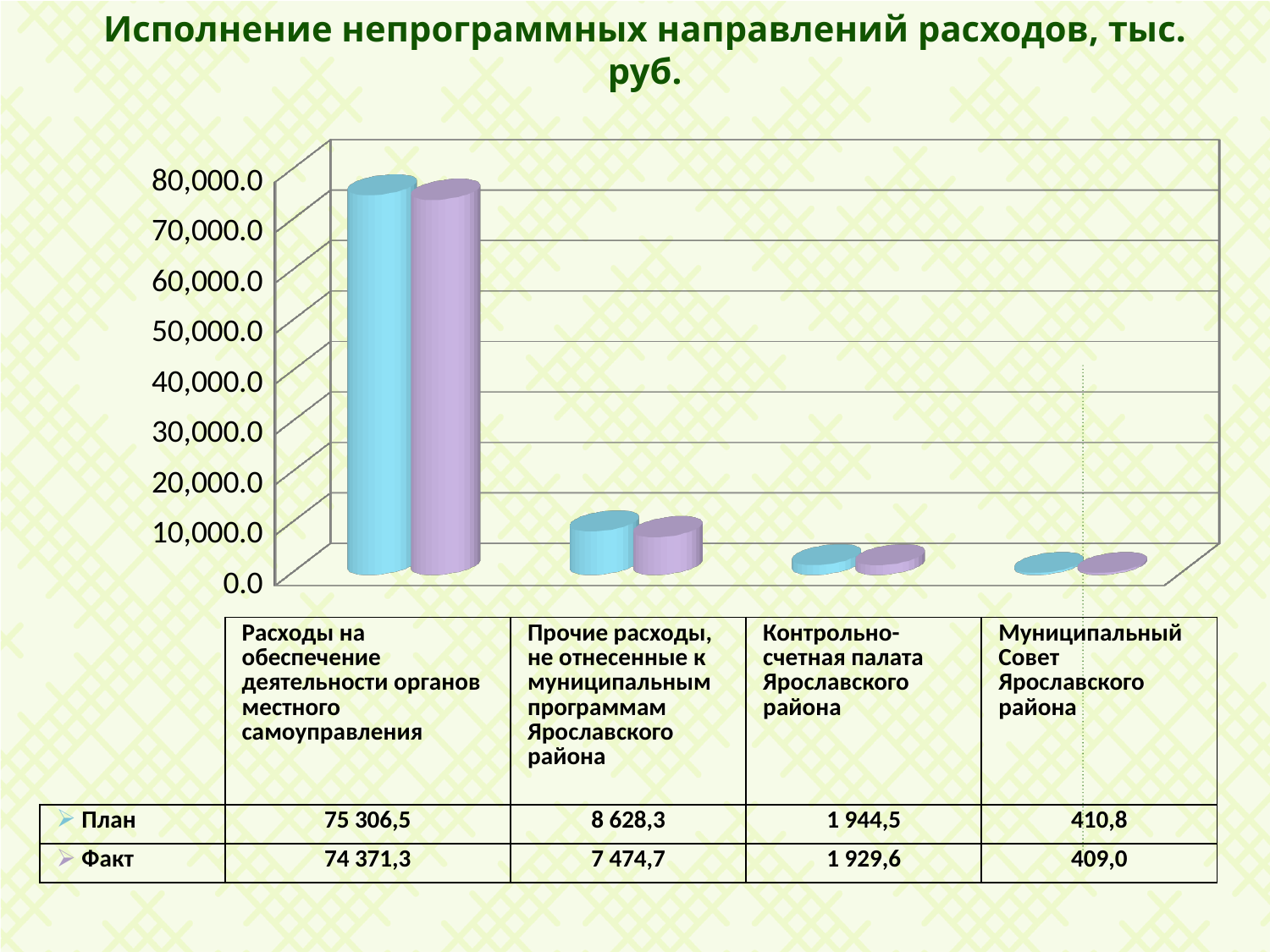
Which category has the lowest План value? Муниципальный Совет Ярославского района What is the План value for Контрольно-счетная палата Ярославского района? 1 944,5 What is the Факт value for Прочие расходы, не отнесенные к муниципальным программам Ярославского района? 7 474,7 What is the План value for Расходы на обеспечение деятельности органов местного самоуправления? 75 306,5 Which is larger for Контрольно-счетная палата Ярославского района: the План value or the Факт value? План How many series does the chart's data table list? 2 What is the difference between the План and Факт values for Прочие расходы, не отнесенные к муниципальным программам Ярославского района? 1 153,6 How many categories are shown on the chart? 4 What is the Факт value for Муниципальный Совет Ярославского района? 409,0 Is the Факт value for Расходы на обеспечение деятельности органов местного самоуправления greater or less than 70,000.0? greater Which category has the highest Факт value? Расходы на обеспечение деятельности органов местного самоуправления What kind of chart is shown on the slide? Bar chart